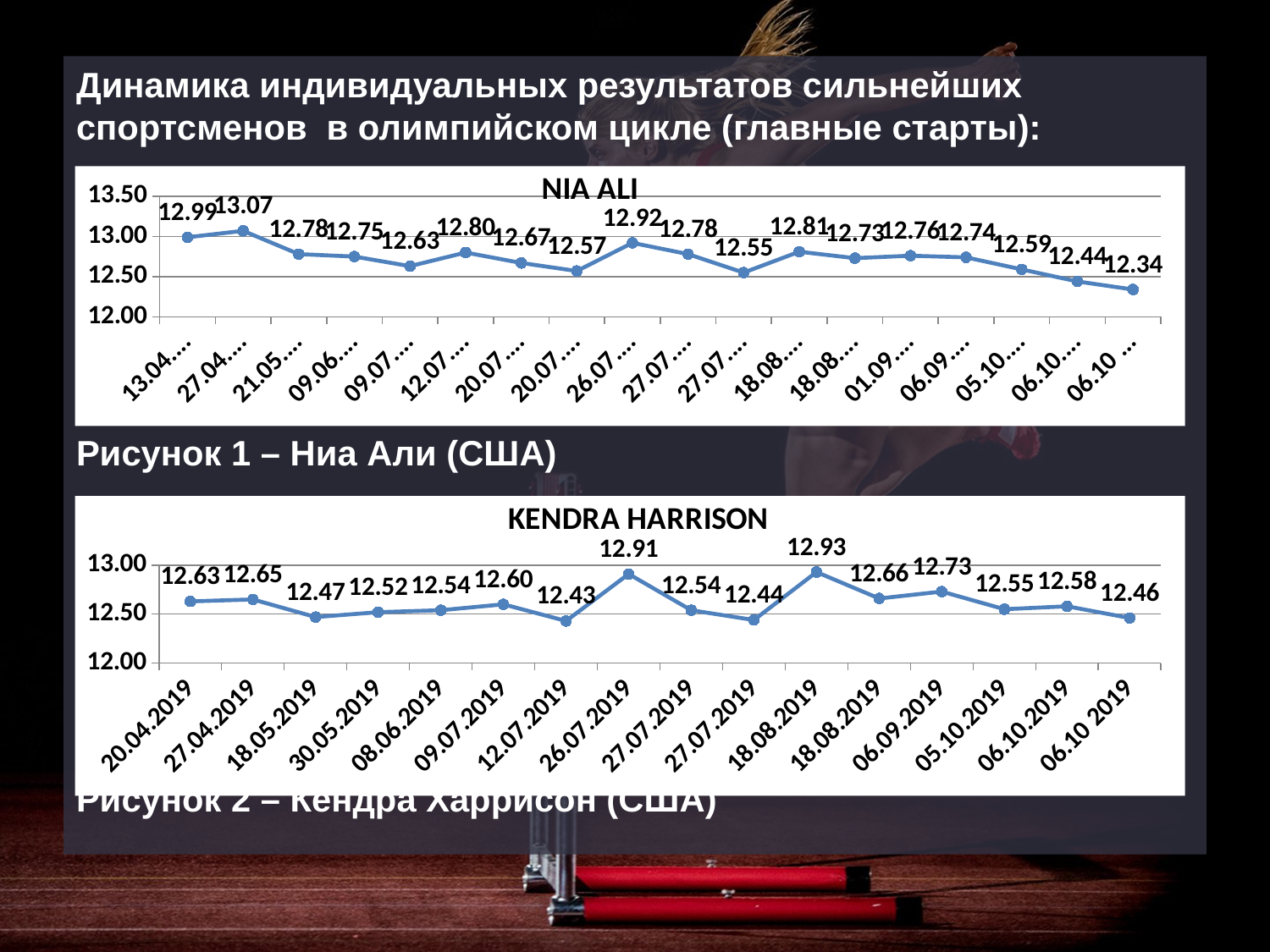
In the KENDRA HARRISON chart, what is the value for 26.07.2019? 12.91 In the NIA ALI chart, what is the value of the first data point? 12.99 How many data points are plotted in the KENDRA HARRISON chart? 16 In the KENDRA HARRISON chart, what is the difference between the values for 26.07.2019 and 12.07.2019? 0.48 How many data points are plotted in the NIA ALI chart? 18 In the KENDRA HARRISON chart, which is larger: the value for 18.05.2019 or the value for 06.09.2019? 06.09.2019 In the NIA ALI chart, what is the difference between the highest value (13.07) and the lowest value (12.34)? 0.73 In the NIA ALI chart, what is the highest value plotted? 13.07 What type of chart is the NIA ALI chart? line chart In the KENDRA HARRISON chart, what is the value for 12.07.2019? 12.43 In the KENDRA HARRISON chart, what is the highest value plotted? 12.93 In the NIA ALI chart, what is the lowest value plotted? 12.34